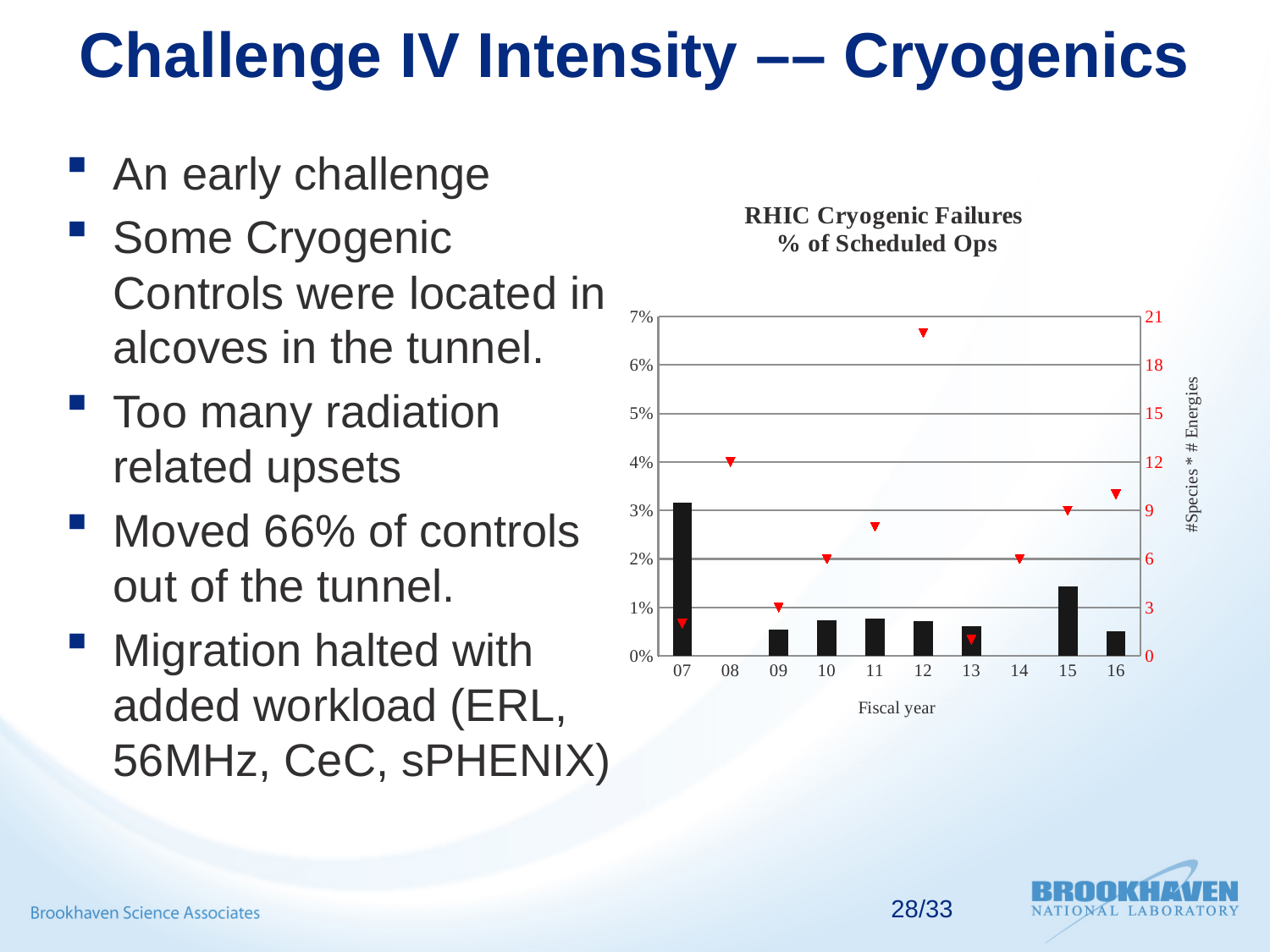
What is the x-axis title of the chart? Fiscal year What is the title of the right-hand (secondary) vertical axis? #Species * # Energies Which fiscal year has the larger cryogenic failures bar, 07 or 15? 07 Which fiscal year has the highest red triangle marker (#Species * # Energies)? 12 What kind of chart is used for the RHIC Cryogenic Failures data? bar chart Is the cryogenic failures bar for fiscal year 15 greater or less than 1%? greater Is the cryogenic failures bar for fiscal year 07 greater or less than 2%? greater Is the cryogenic failures bar for fiscal year 09 greater or less than 1%? less Which fiscal year has the lowest red triangle marker (#Species * # Energies)? 13 Which fiscal year has the tallest bar for cryogenic failures as % of scheduled ops? 07 How many fiscal years are shown on the x axis of the chart? 10